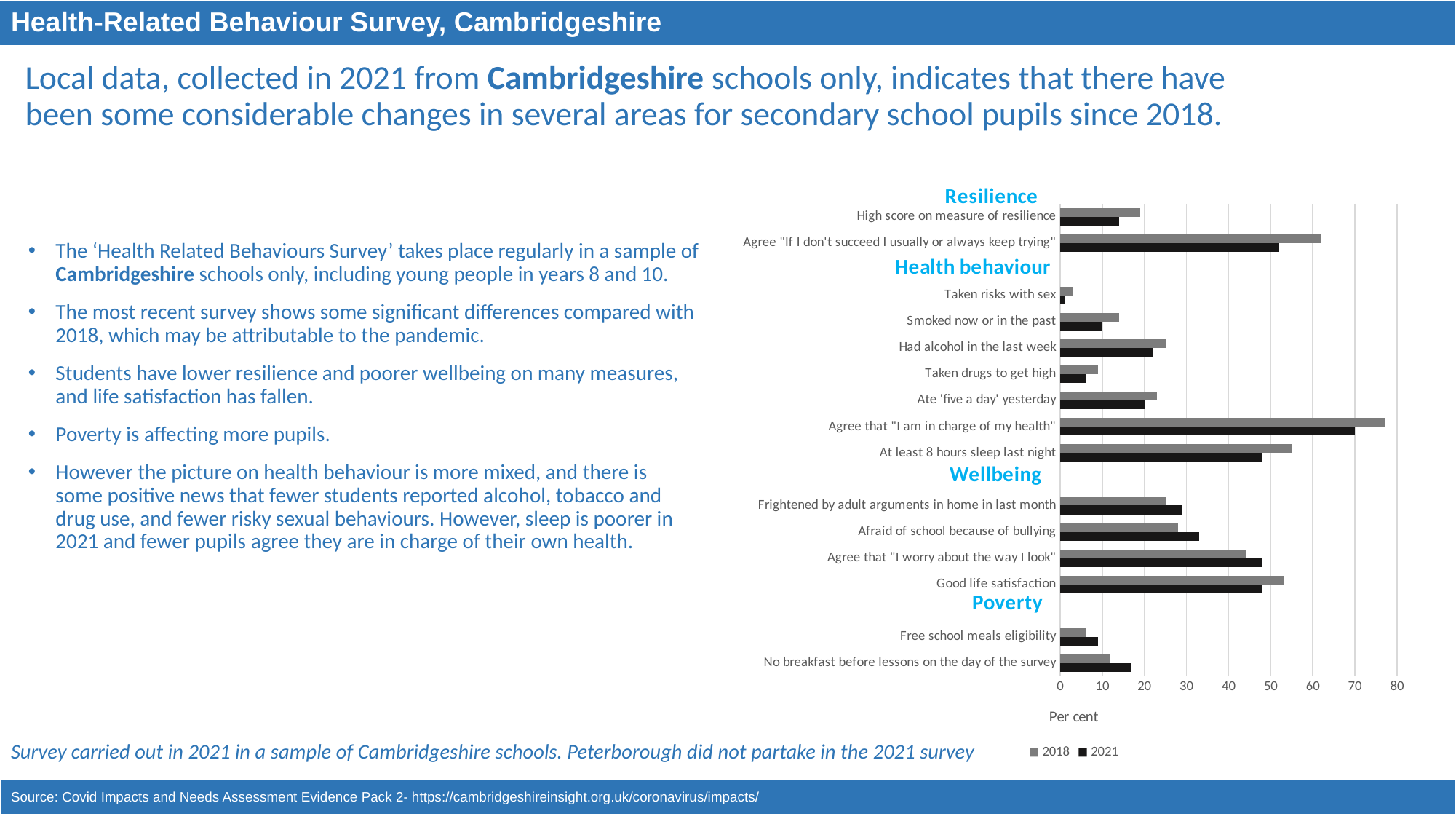
For Afraid of school because of bullying, which year has the larger value, 2018 or 2021? 2021 Is the 2018 value for Taken risks with sex greater or less than 10? less Is the 2018 value for Agree that "I am in charge of my health" greater or less than 70? greater What kind of chart is shown on the slide? bar chart How many series does the chart legend list? 2 Is the 2021 value for No breakfast before lessons on the day of the survey greater or less than 20? less Which two years are listed in the chart legend? 2018 and 2021 Which category has the highest 2018 value in the chart? Agree that "I am in charge of my health" What is the label on the chart's horizontal axis? Per cent Which category has the lowest 2021 value in the chart? Taken risks with sex How many categories (measures) are plotted in the chart? 15 For Agree "If I don't succeed I usually or always keep trying", which year has the larger value, 2018 or 2021? 2018